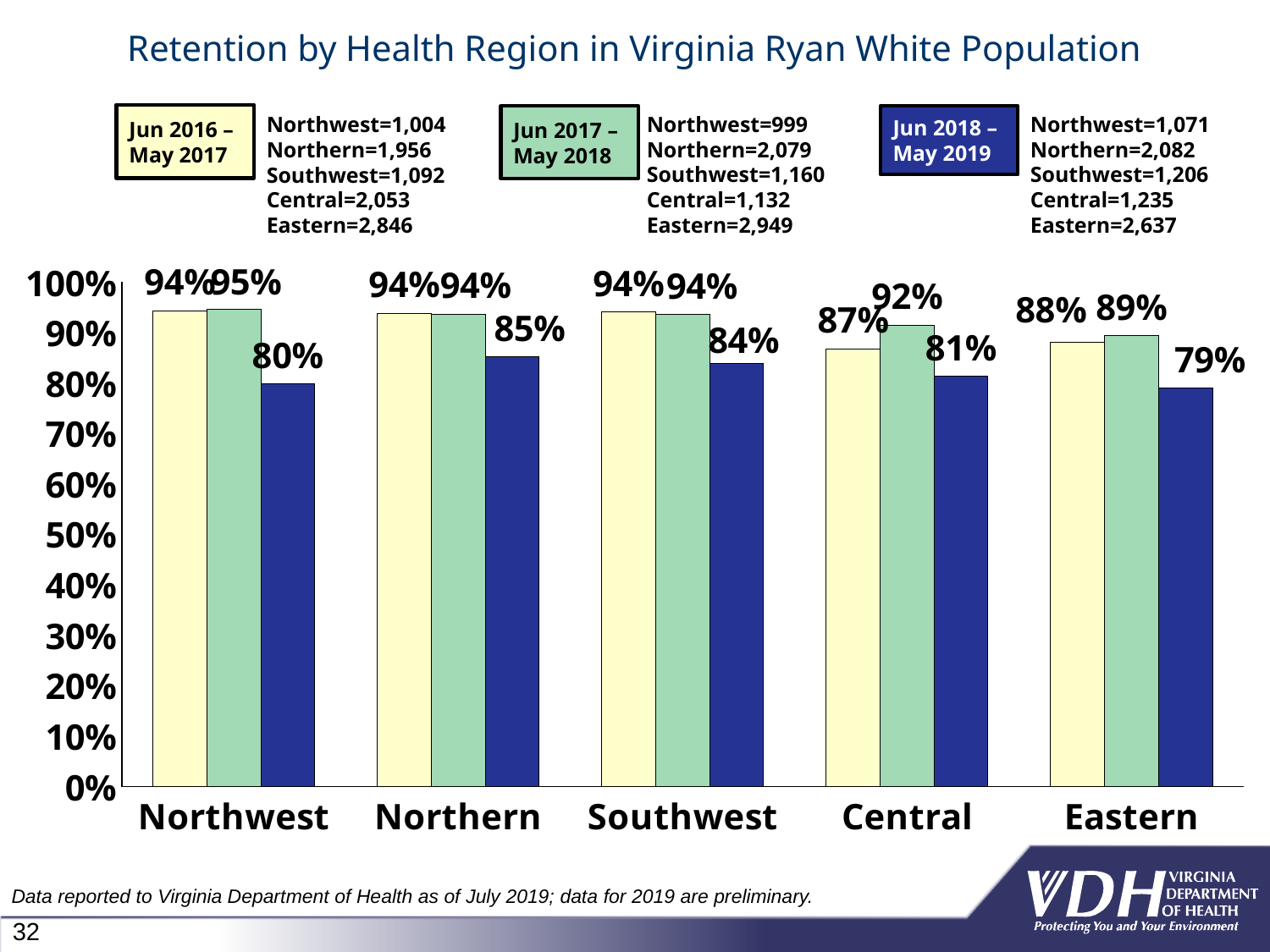
Which health region has the lowest retention in Jun 2018 – May 2019? Eastern Which is larger for Central: the Jun 2016 – May 2017 value or the Jun 2017 – May 2018 value? Jun 2017 – May 2018 What is the Northern population count listed for Jun 2018 – May 2019? 2,082 How many time periods (series) are shown in the chart? 3 What is the difference between the Jun 2017 – May 2018 and Jun 2018 – May 2019 retention values for Northwest? 15% What type of chart is shown on the slide? Bar chart What is the retention value for Northwest in Jun 2018 – May 2019? 80% How many health regions are shown on the x axis? 5 What is the retention value for Northern in Jun 2018 – May 2019? 85% What is the retention value for Central in Jun 2017 – May 2018? 92% What is the retention value for Eastern in Jun 2016 – May 2017? 88% Which health region has the lowest retention in Jun 2016 – May 2017? Central